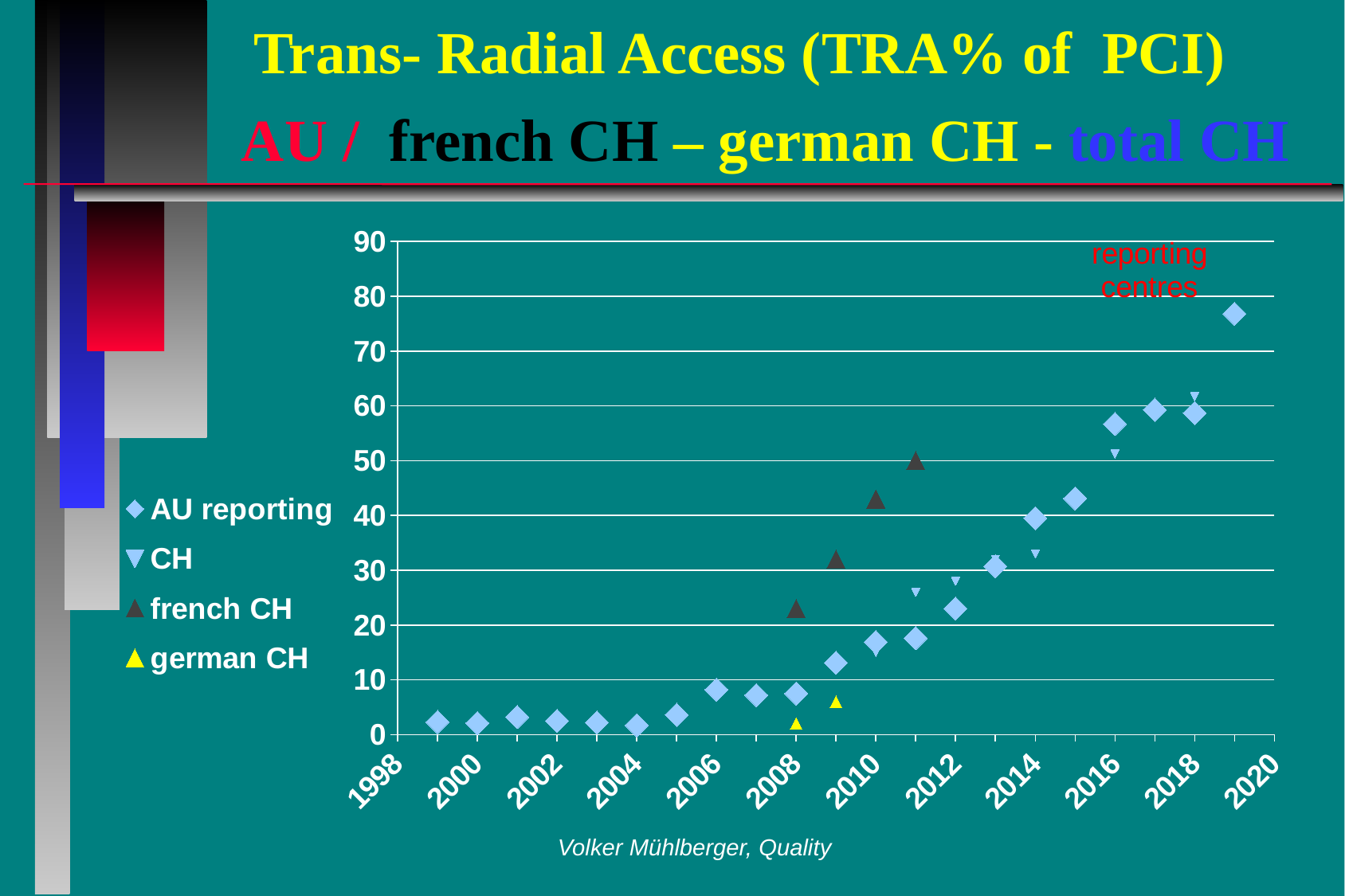
Is the german CH value for 2009 greater or less than 10? less Is the AU reporting value for 2019 greater or less than 70? greater Do the AU reporting values rise or fall from 1999 to 2019? rise Is the AU reporting value for 2012 greater or less than 30? less How many series does the legend list? 4 In which year is the AU reporting value highest? 2019 In 2010, which is larger: the french CH value or the AU reporting value? french CH What kind of chart is shown on the slide? scatter chart Which series is shown with yellow triangle markers in the legend? german CH